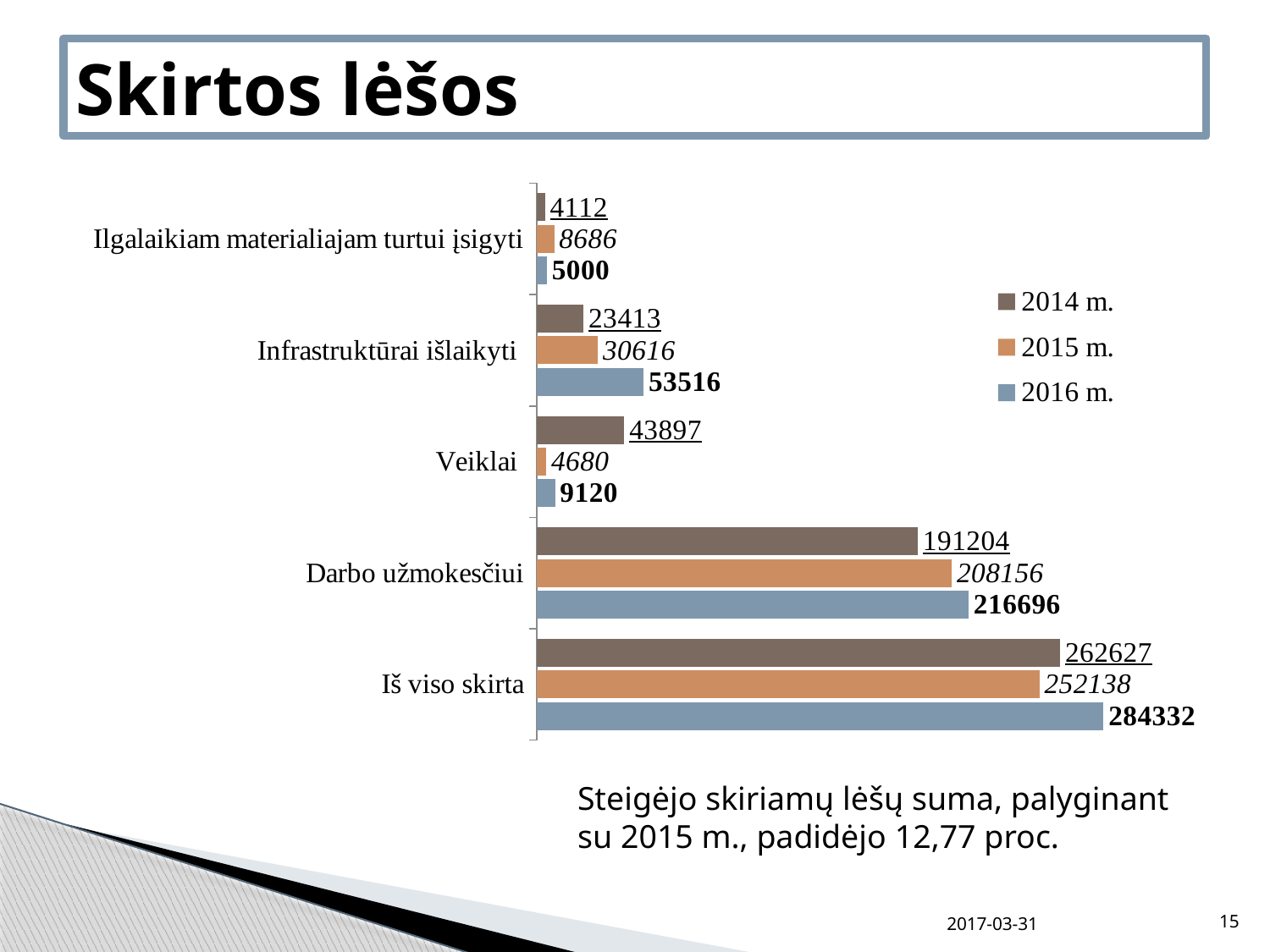
Which year has the highest value in the Infrastruktūrai išlaikyti category? 2016 m. What is the value for 2016 m. in the Iš viso skirta category? 284332 How many categories are shown on the chart? 5 What is the value for 2014 m. in the Veiklai category? 43897 What is the value for 2015 m. in the Ilgalaikiam materialiajam turtui įsigyti category? 8686 Which year has the lowest value in the Veiklai category? 2015 m. How many series does the legend list? 3 What is the difference between the 2016 m. and 2015 m. values in the Iš viso skirta category? 32194 What is the difference between the 2016 m. and 2014 m. values in the Darbo užmokesčiui category? 25492 What is the value for 2015 m. in the Darbo užmokesčiui category? 208156 Which is larger in the Iš viso skirta category: the 2014 m. value or the 2015 m. value? 2014 m. What kind of chart is shown on the slide? Bar chart